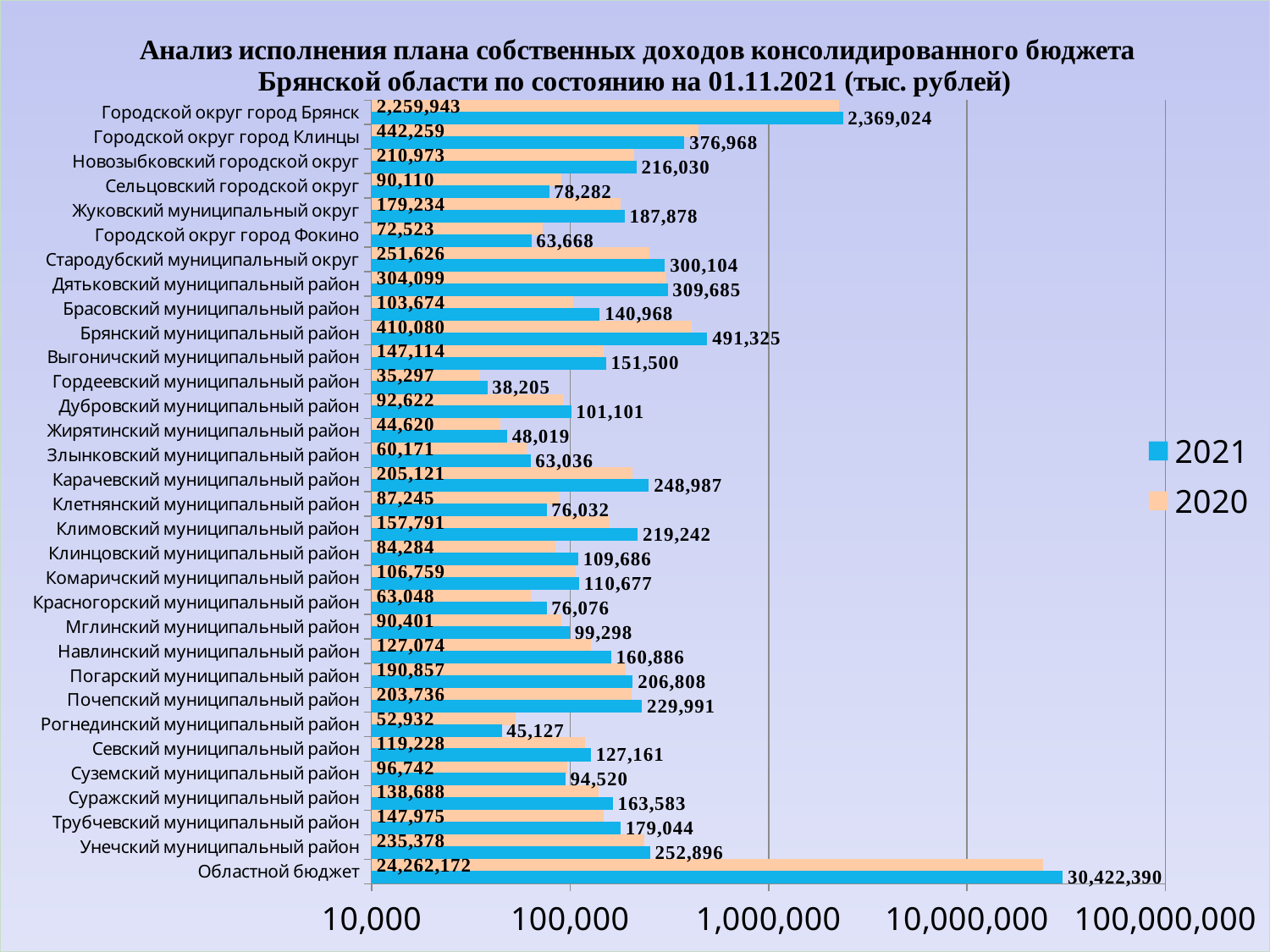
For Сельцовский городской округ, which is larger: the 2021 value or the 2020 value? 2020 What is the 2021 value for Областной бюджет? 30,422,390 How many series does the legend list? 2 Which category has the highest 2021 value? Областной бюджет What is the difference between the 2021 and 2020 values for Городской округ город Брянск? 109,081 What is the 2020 value for Унечский муниципальный район? 235,378 Which category has the lowest 2021 value? Гордеевский муниципальный район What is the 2021 value for Городской округ город Брянск? 2,369,024 How many categories are plotted on the chart? 32 What is the 2020 value for Городской округ город Клинцы? 442,259 What kind of chart is shown on the slide? bar chart Which series is shown in blue according to the legend? 2021